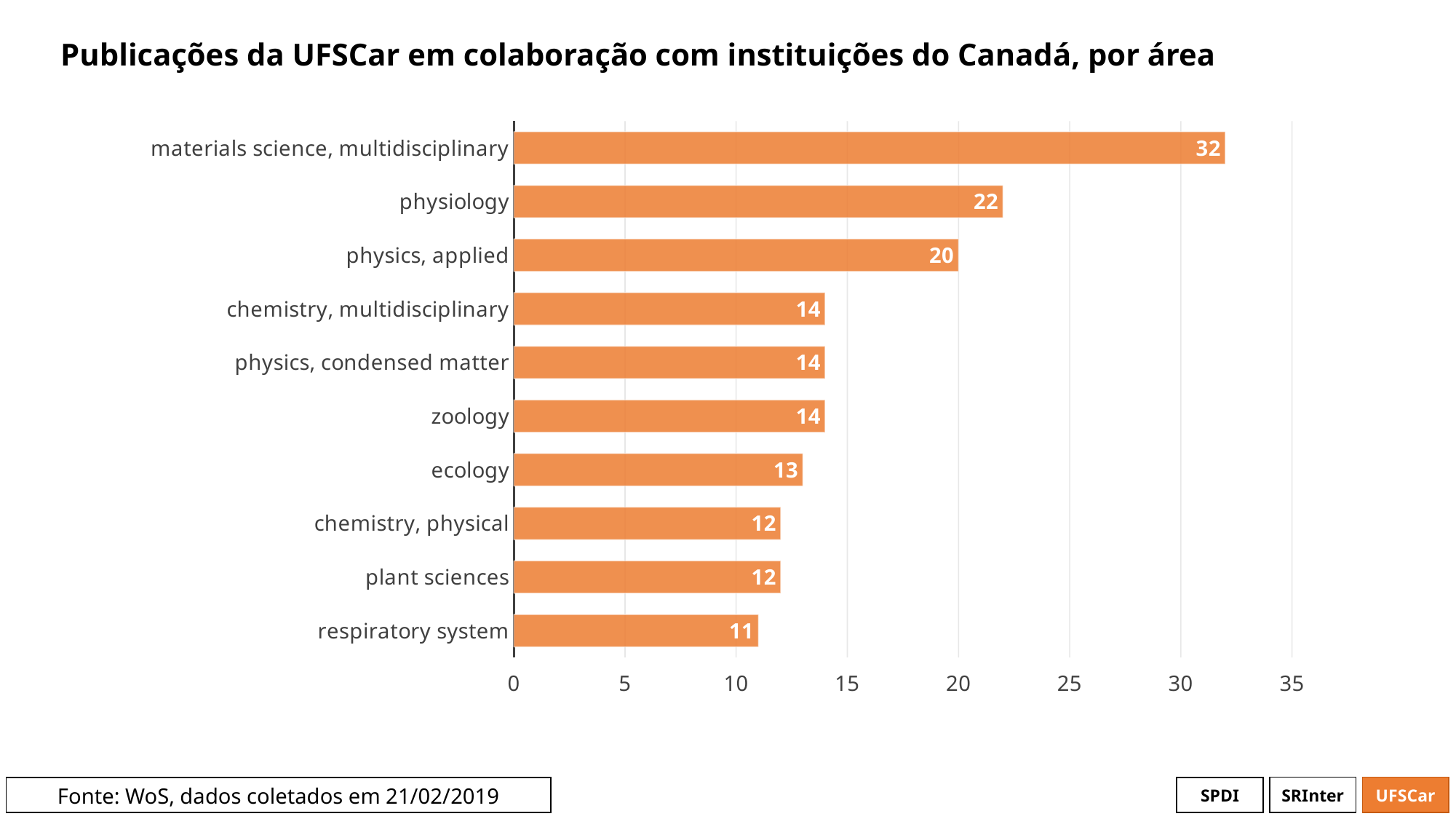
How many areas are shown in the chart? 10 What is the value for ecology? 13 What is the value for physics, applied? 20 Is the value for physiology greater or less than 20? greater What is the difference between materials science, multidisciplinary and physiology? 10 How many publications are shown for physiology? 22 What is the difference between zoology and respiratory system? 3 What kind of chart is shown on the slide? bar chart Which area has the lowest number of publications? respiratory system Which is larger, physics, applied or chemistry, multidisciplinary? physics, applied Which area has the highest number of publications? materials science, multidisciplinary What is the title of the chart? Publicações da UFSCar em colaboração com instituições do Canadá, por área